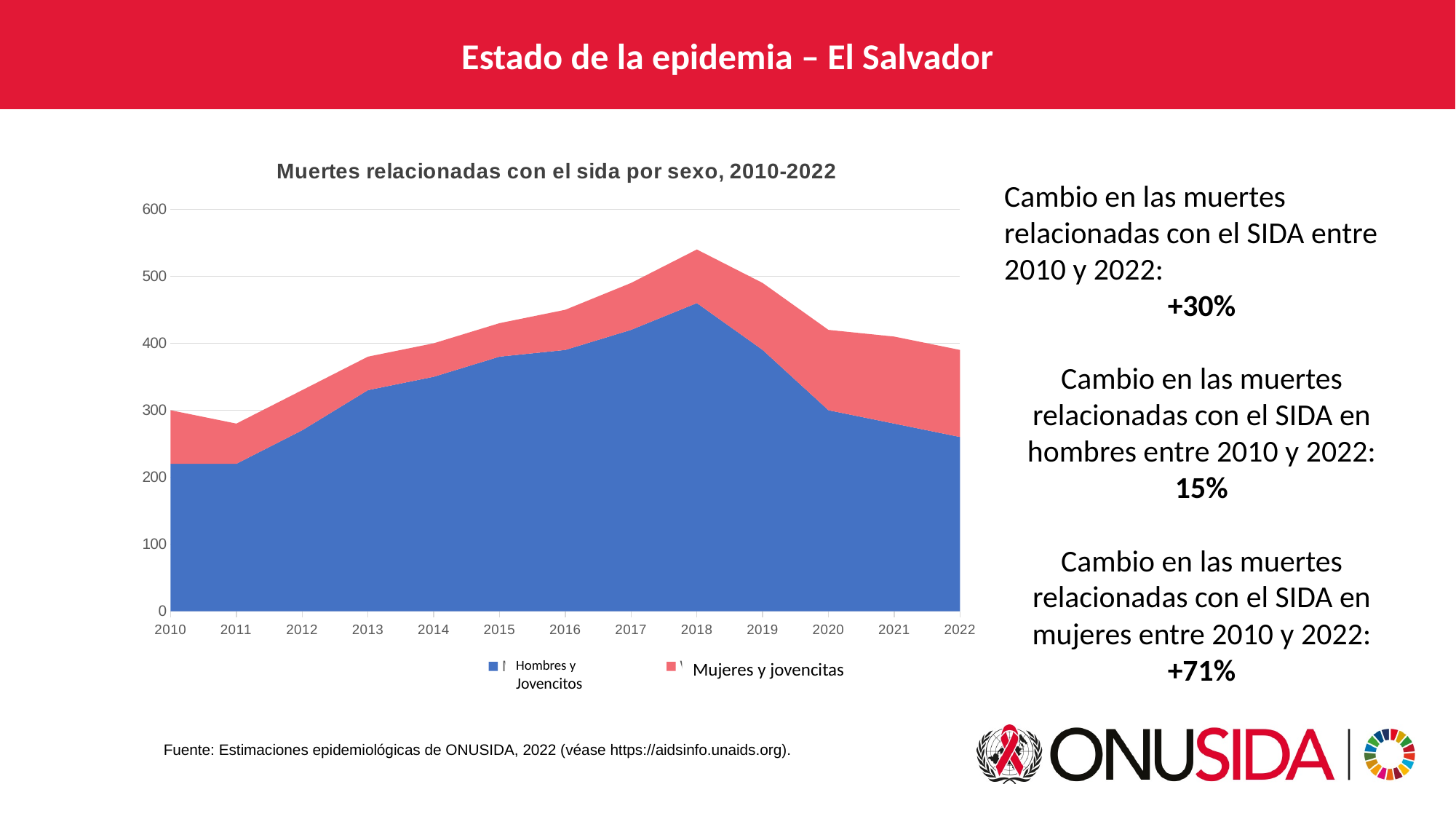
What kind of chart is shown on the slide? Stacked area chart What is the title of the chart? Muertes relacionadas con el sida por sexo, 2010-2022 Does the combined total of both series rise or fall between 2018 and 2022? Fall How many years are plotted along the x axis of the chart? 13 In which year is the value for 'Hombres y jovencitos' highest? 2018 In which year does the total of AIDS-related deaths (both series combined) reach its highest point? 2018 In which year is the combined total of both series lowest? 2011 Is the value for 'Hombres y jovencitos' in 2010 greater or less than 300? less How many series does the chart's legend list? 2 Is the combined total of both series in 2018 greater or less than 500? greater Which colour represents the series 'Mujeres y jovencitas' in the chart? Red (pink) Is the value for 'Hombres y jovencitos' in 2018 greater or less than 400? greater